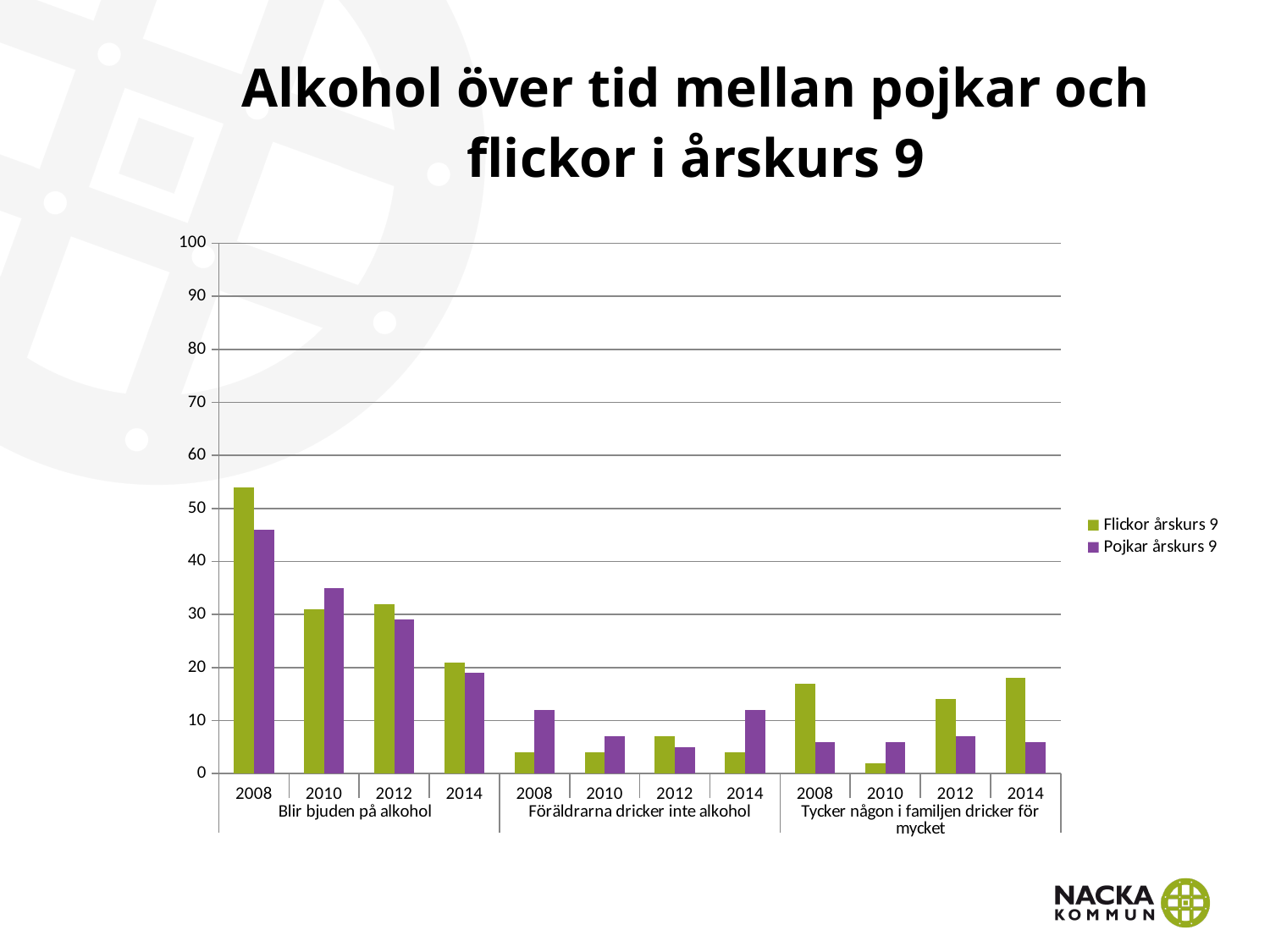
How many question categories (groups) are shown along the x axis? 3 In 2008 under 'Föräldrarna dricker inte alkohol', which is larger: Flickor årskurs 9 or Pojkar årskurs 9? Pojkar årskurs 9 How many series does the legend list? 2 Is the value for Flickor årskurs 9 in 2014 under 'Tycker någon i familjen dricker för mycket' greater or less than 10? greater Which bar is the lowest under 'Tycker någon i familjen dricker för mycket'? Flickor årskurs 9, 2010 Is the value for Flickor årskurs 9 in 2008 under 'Blir bjuden på alkohol' greater or less than 50? greater Is the value for Pojkar årskurs 9 in 2008 under 'Blir bjuden på alkohol' greater or less than 50? less In 2010 under 'Blir bjuden på alkohol', which is larger: Flickor årskurs 9 or Pojkar årskurs 9? Pojkar årskurs 9 Do the values for Flickor årskurs 9 under 'Blir bjuden på alkohol' rise or fall from 2008 to 2014? fall Which bar is the highest in the whole chart? Flickor årskurs 9, 2008, Blir bjuden på alkohol What colour represents Pojkar årskurs 9 in the legend? purple What kind of chart is shown on the slide? bar chart